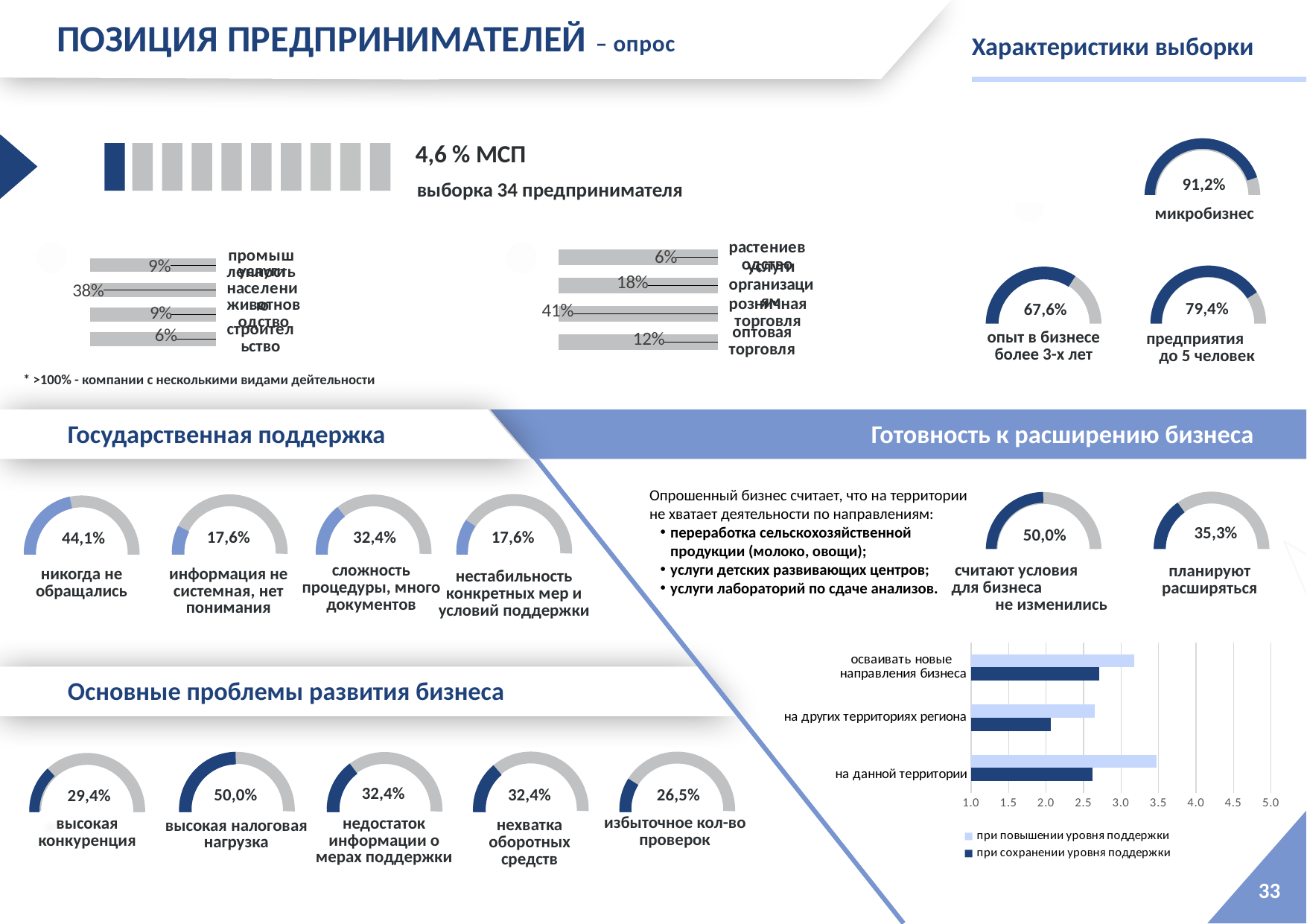
In the 'Характеристики выборки' section, what percentage is shown for 'предприятия до 5 человек'? 79,4% In the bottom-right bar chart, is the value for 'на данной территории' in the series 'при повышении уровня поддержки' greater or less than 3.0? greater In the 'Характеристики выборки' section, what percentage is shown for 'микробизнес'? 91,2% In the 'Основные проблемы развития бизнеса' section, which problem has the highest percentage? высокая налоговая нагрузка In the 'Государственная поддержка' section, what is the difference between 'никогда не обращались' and 'сложность процедуры, много документов'? 11,7% What kind of chart is the one in the bottom-right with the legend 'при повышении уровня поддержки'? bar chart In the bottom-right bar chart, is the value for 'на других территориях региона' in the series 'при сохранении уровня поддержки' greater or less than 2.5? less In the bottom-right bar chart, how many categories are shown? 3 In the bottom-right bar chart, which category has the highest value in the series 'при повышении уровня поддержки'? на данной территории In the 'Готовность к расширению бизнеса' section, which is larger: 'считают условия для бизнеса не изменились' or 'планируют расширяться'? считают условия для бизнеса не изменились In the bottom-right bar chart, which category has the lowest value in the series 'при сохранении уровня поддержки'? на других территориях региона In the bottom-right bar chart, how many series does the legend list? 2